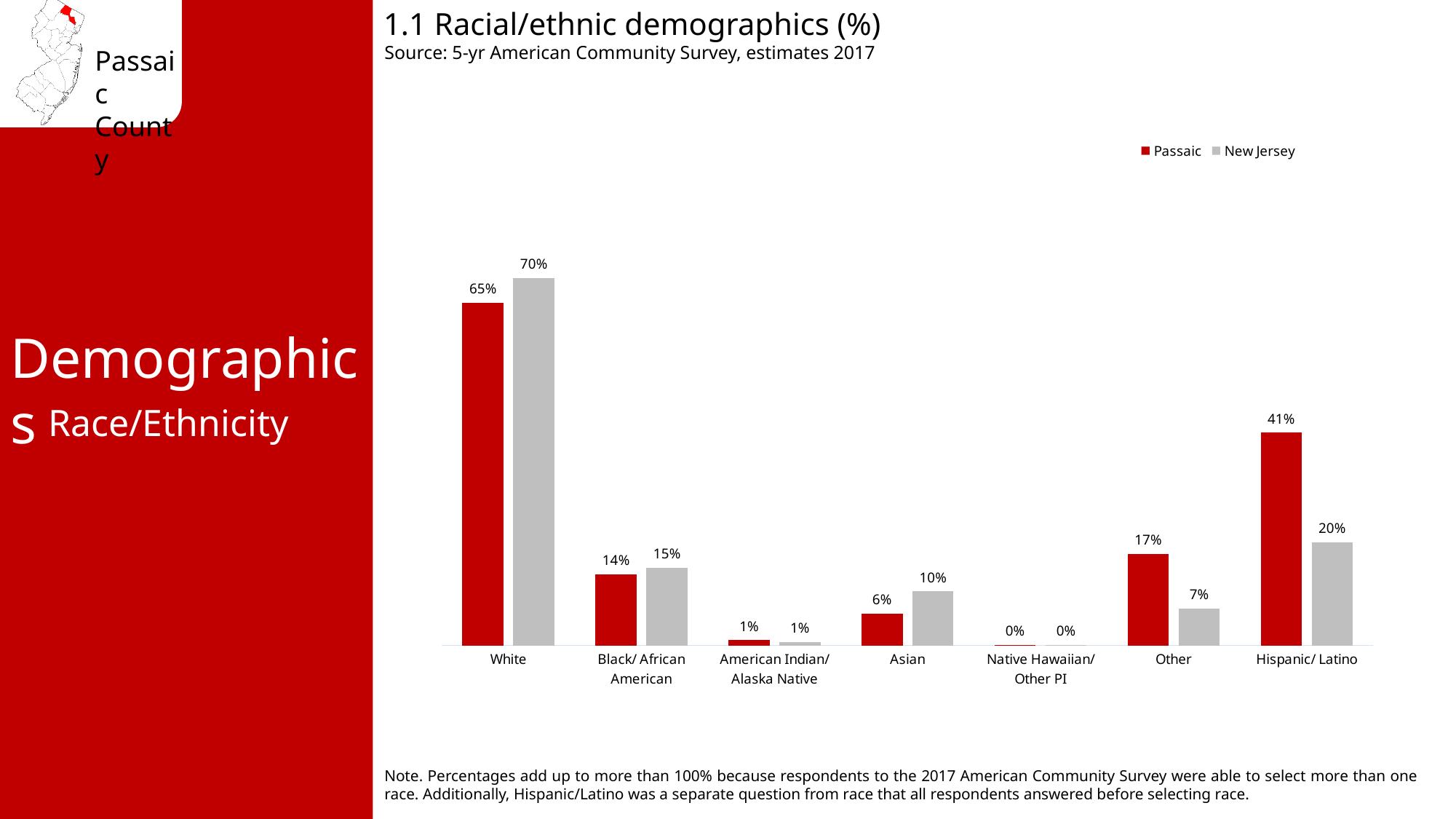
Which category has the highest Passaic value? White What kind of chart is shown on the slide? Bar chart What is the difference between the New Jersey and Passaic values for White? 5% What is the Passaic value for Other? 17% Which is larger for Other: the Passaic value or the New Jersey value? Passaic Which category has the lowest New Jersey value? Native Hawaiian/ Other PI How many categories are shown on the x axis? 7 How many series does the legend list? 2 What is the New Jersey value for Hispanic/ Latino? 20% What is the difference between the Passaic and New Jersey values for Hispanic/ Latino? 21% What is the New Jersey value for Asian? 10% What is the Passaic value for White? 65%